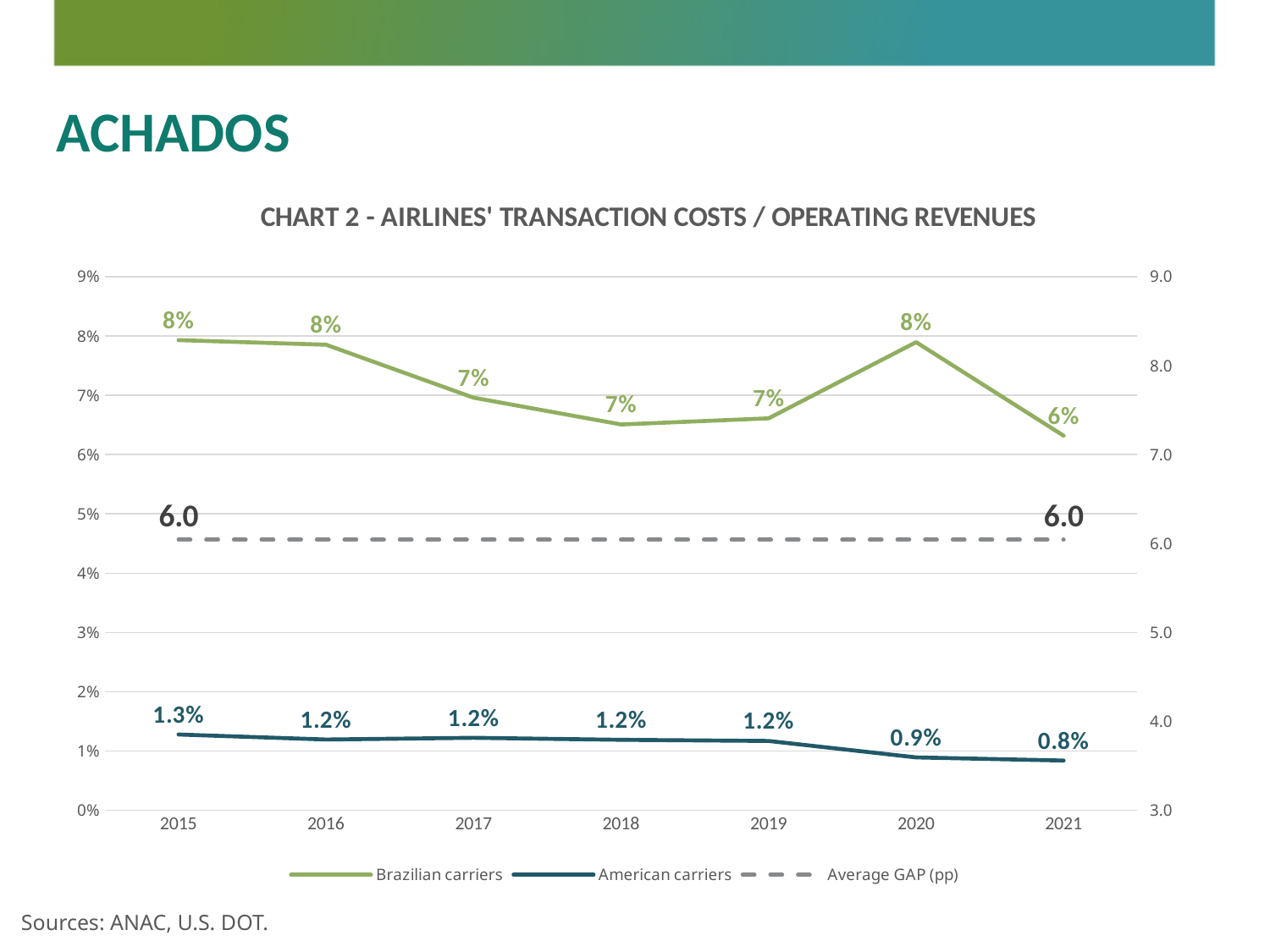
What is the value for Brazilian carriers in 2021? 6% What is the difference between the American carriers values in 2015 and 2021? 0.5% What kind of chart is shown on the slide? Line chart What is the value for American carriers in 2015? 1.3% What value is labelled on the Average GAP (pp) line? 6.0 How many years are shown on the x axis? 7 What is the value for American carriers in 2020? 0.9% How many series does the legend list? 3 In which year is the value for American carriers highest? 2015 In 2019, which series has the larger value, Brazilian carriers or American carriers? Brazilian carriers In which year is the value for American carriers lowest? 2021 In which year is the value for Brazilian carriers lowest? 2021